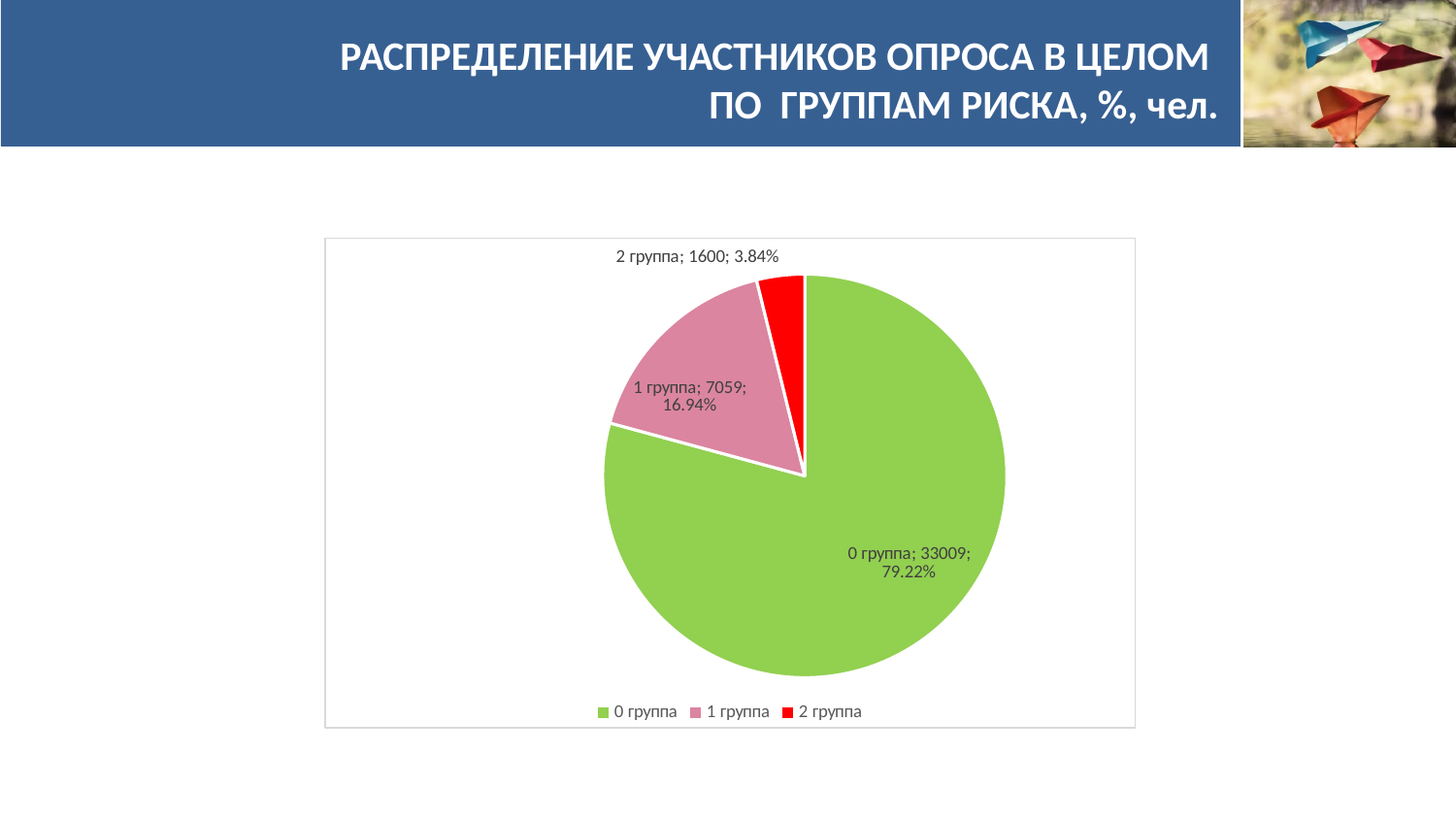
What is the difference in number of people between 1 группа and 2 группа? 5459 Which group has the largest slice? 0 группа What colour is the slice for 2 группа? Red How many entries does the legend list? 3 What kind of chart is shown on the slide? Pie chart How many people are in 2 группа? 1600 How many people are in 1 группа? 7059 What share of the pie does 2 группа represent? 3.84% How many slices does the pie chart have? 3 How many people are in 0 группа? 33009 Which group has the smallest slice? 2 группа What share of the pie does 1 группа represent? 16.94%